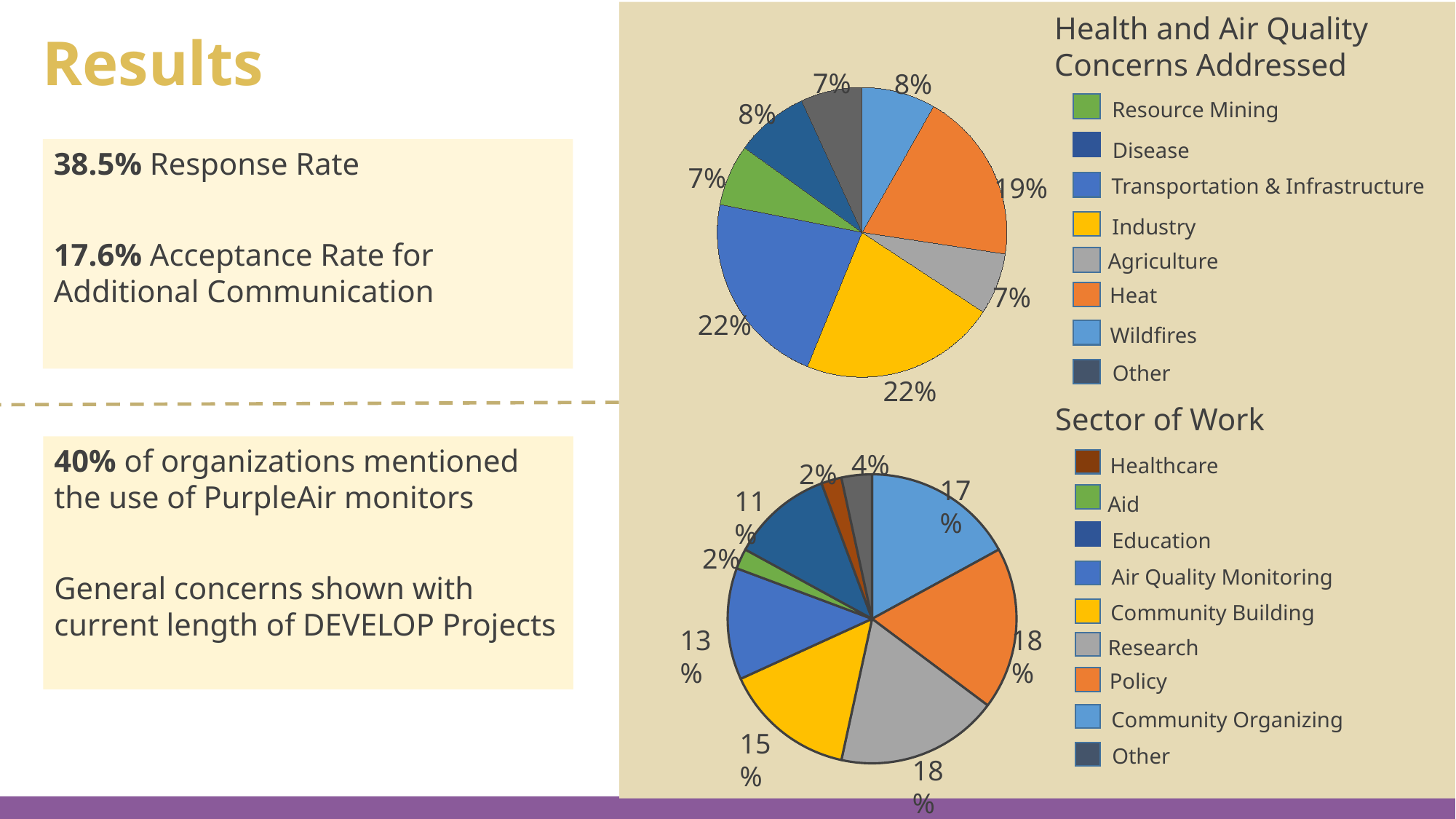
In the Health and Air Quality Concerns Addressed pie chart, how many categories does the legend list? 8 In the Health and Air Quality Concerns Addressed pie chart, what percentage is shown for Disease? 8% In the Health and Air Quality Concerns Addressed pie chart, what percentage is shown for Industry? 22% What type of chart is used for Sector of Work? Pie chart In the Sector of Work pie chart, what percentage is shown for Community Organizing? 17% In the Health and Air Quality Concerns Addressed pie chart, what percentage is shown for Heat? 19% In the Sector of Work pie chart, what percentage is shown for Community Building? 15% In the Health and Air Quality Concerns Addressed pie chart, what is the difference between the Transportation & Infrastructure share and the Resource Mining share? 15% In the Sector of Work pie chart, how many categories does the legend list? 9 In the Health and Air Quality Concerns Addressed pie chart, which is larger, Heat or Wildfires? Heat In the Sector of Work pie chart, which is larger, Air Quality Monitoring or Other? Air Quality Monitoring In the Sector of Work pie chart, what percentage is shown for Education? 11%